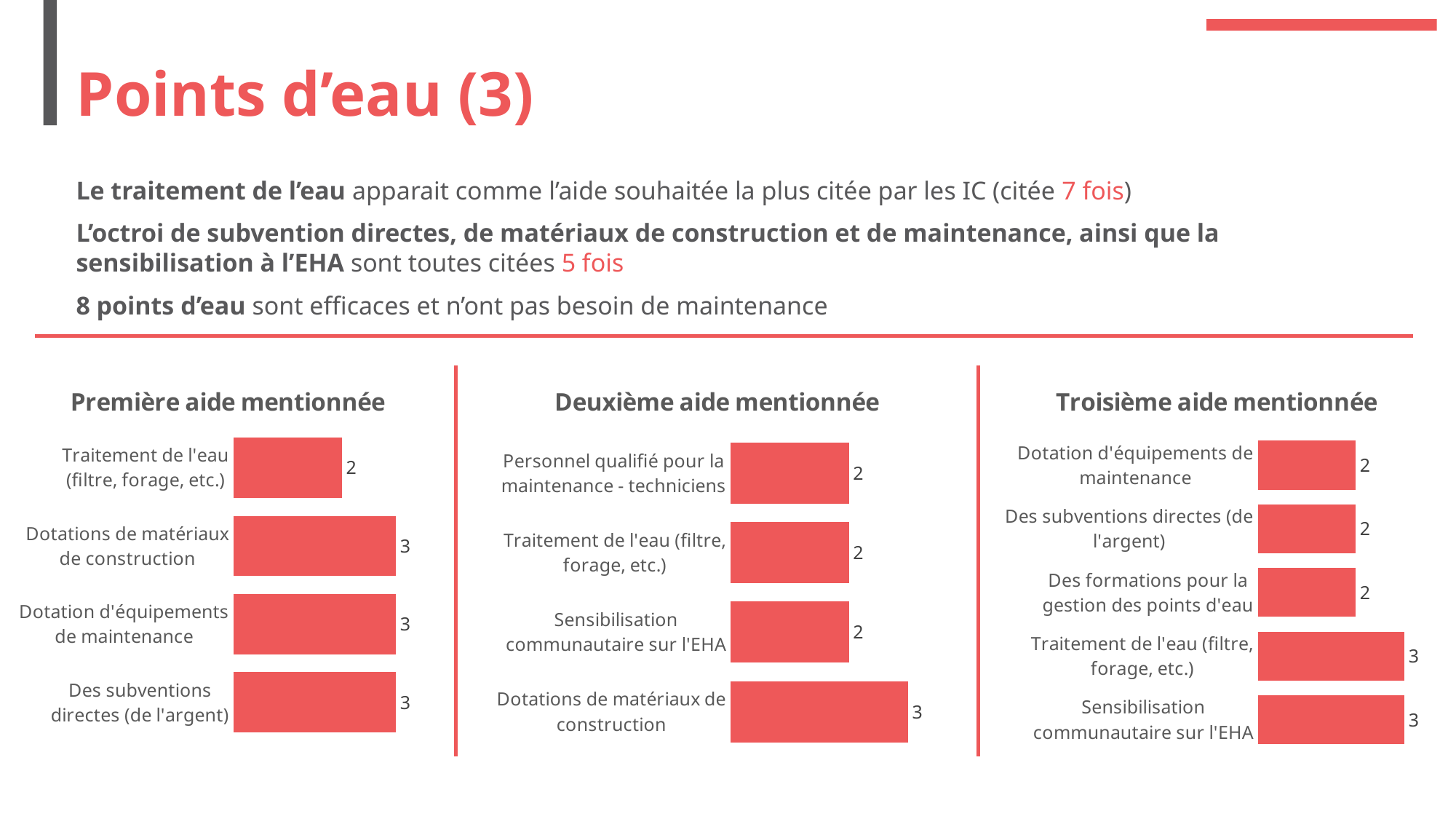
In the 'Première aide mentionnée' chart, what is the value for 'Traitement de l'eau (filtre, forage, etc.)'? 2 In the 'Troisième aide mentionnée' chart, what is the value for 'Des formations pour la gestion des points d'eau'? 2 In the 'Première aide mentionnée' chart, which category has the lowest value? Traitement de l'eau (filtre, forage, etc.) How many charts are shown on the slide? 3 In the 'Deuxième aide mentionnée' chart, which category has the highest value? Dotations de matériaux de construction In the 'Première aide mentionnée' chart, how many categories are shown? 4 In the 'Troisième aide mentionnée' chart, how many categories are shown? 5 In the 'Troisième aide mentionnée' chart, which is larger: 'Traitement de l'eau (filtre, forage, etc.)' or 'Des subventions directes (de l'argent)'? Traitement de l'eau (filtre, forage, etc.) What type of chart is the 'Troisième aide mentionnée' chart? Bar chart In the 'Deuxième aide mentionnée' chart, what is the value for 'Dotations de matériaux de construction'? 3 In the 'Première aide mentionnée' chart, what is the difference between 'Dotations de matériaux de construction' and 'Traitement de l'eau (filtre, forage, etc.)'? 1 In the 'Deuxième aide mentionnée' chart, what is the value for 'Sensibilisation communautaire sur l'EHA'? 2